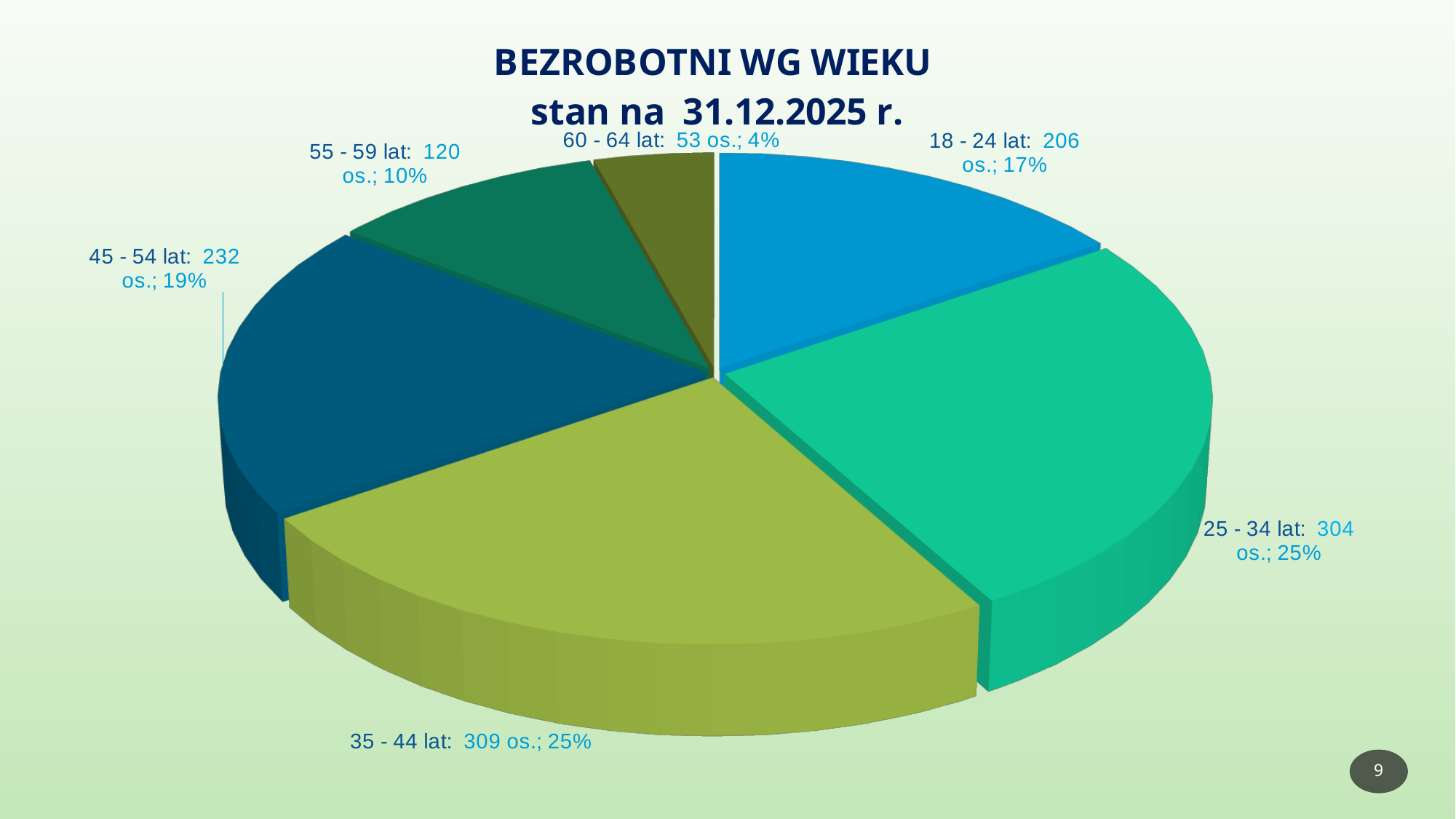
How many unemployed people are in the 18 - 24 lat age group? 206 os. What kind of chart is shown on the slide? pie chart Which group is larger, 45 - 54 lat or 55 - 59 lat? 45 - 54 lat What is the difference in number of people between the 35 - 44 lat and 25 - 34 lat groups? 5 What date is given in the chart title? 31.12.2025 r. What share of the pie does the 45 - 54 lat group represent? 19% What percentage share does the 60 - 64 lat group have? 4% How many age groups (slices) does the pie chart show? 6 What is the value for the 55 - 59 lat group? 120 os. Which age group has the smallest number of unemployed? 60 - 64 lat What is the difference in number of people between the 18 - 24 lat and 60 - 64 lat groups? 153 Which age group has the largest number of unemployed? 35 - 44 lat